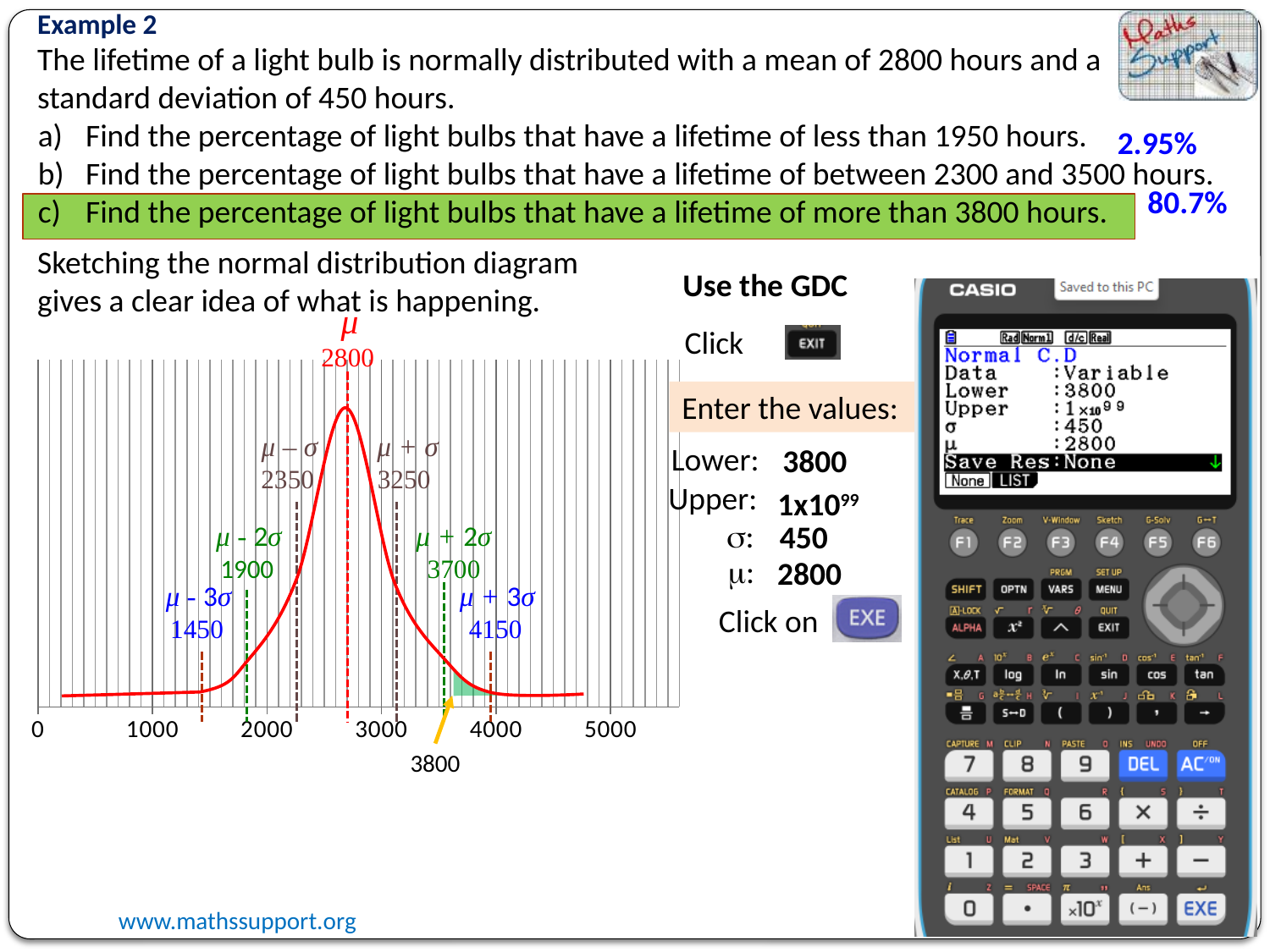
Which is larger on the normal distribution diagram, the value at μ + 2σ or the value at μ + σ? μ + 2σ What colour is the normal distribution curve on the diagram? red What is the difference between the values labelled at μ + 3σ and μ on the normal distribution diagram? 1350 What is the difference between the values labelled at μ + σ and μ − σ on the normal distribution diagram? 900 What value is labelled at μ + 3σ on the normal distribution diagram? 4150 What value is labelled at the mean μ on the normal distribution diagram? 2800 What value is labelled at μ − 3σ on the normal distribution diagram? 1450 What value does the arrow below the shaded region of the normal distribution diagram point to? 3800 What value is labelled at μ + 2σ on the normal distribution diagram? 3700 What kind of chart is the normal distribution diagram on the slide? line chart What value is labelled at μ − σ on the normal distribution diagram? 2350 What value is labelled at μ + σ on the normal distribution diagram? 3250